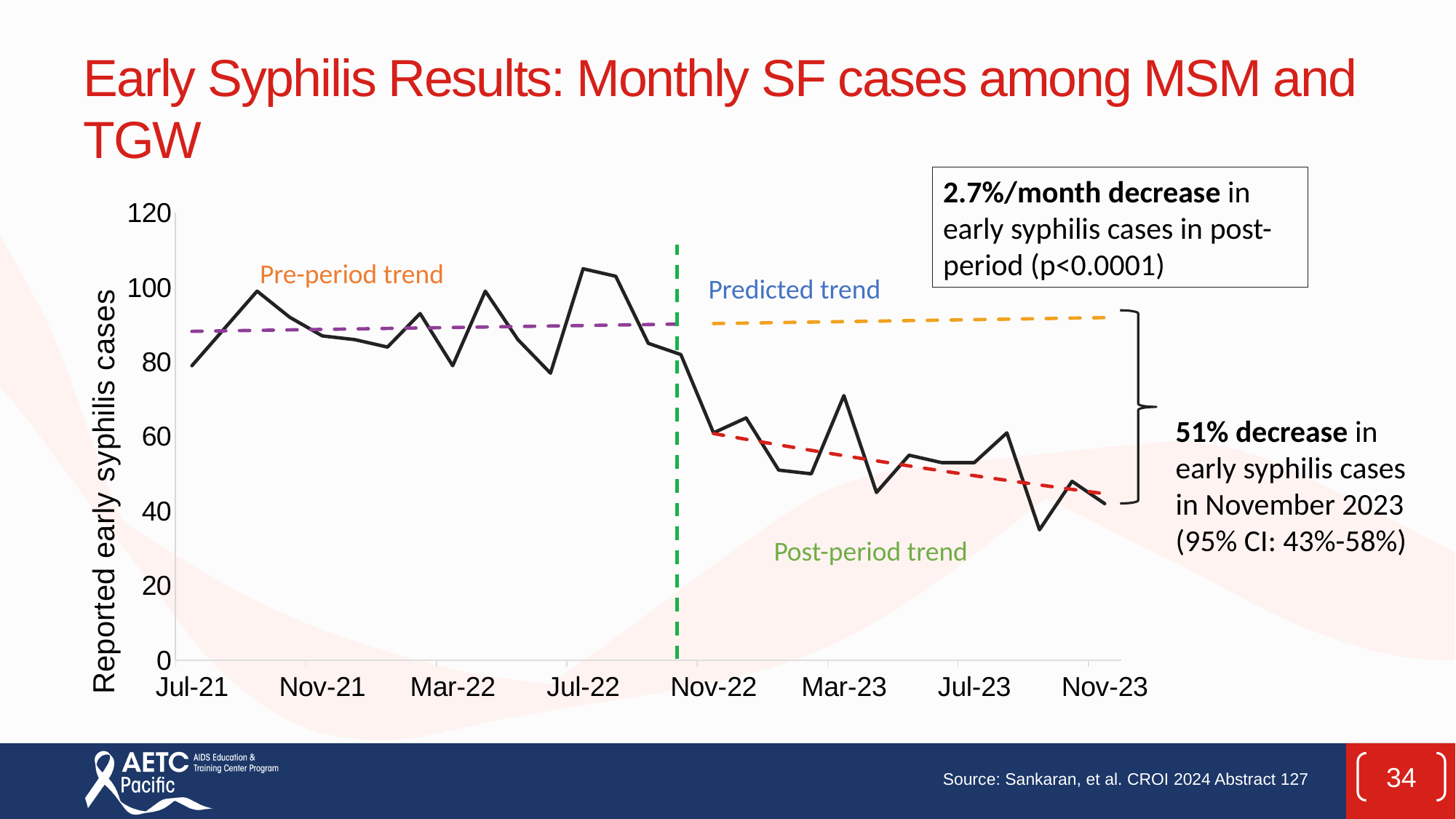
Which is larger, the value for Jul-21 or the value for Nov-23? Jul-21 Is the value for Nov-23 greater or less than 60? less What is the label of the dashed trend line drawn over the data before the green vertical line? Pre-period trend Do the reported early syphilis cases generally rise or fall between Nov-22 and Nov-23? fall What kind of chart is shown on the slide? line chart What is the label on the y axis of the chart? Reported early syphilis cases How many month labels are shown on the x axis? 8 Is the value for Mar-23 greater or less than 40? greater Is the value for Nov-22 greater or less than 80? less